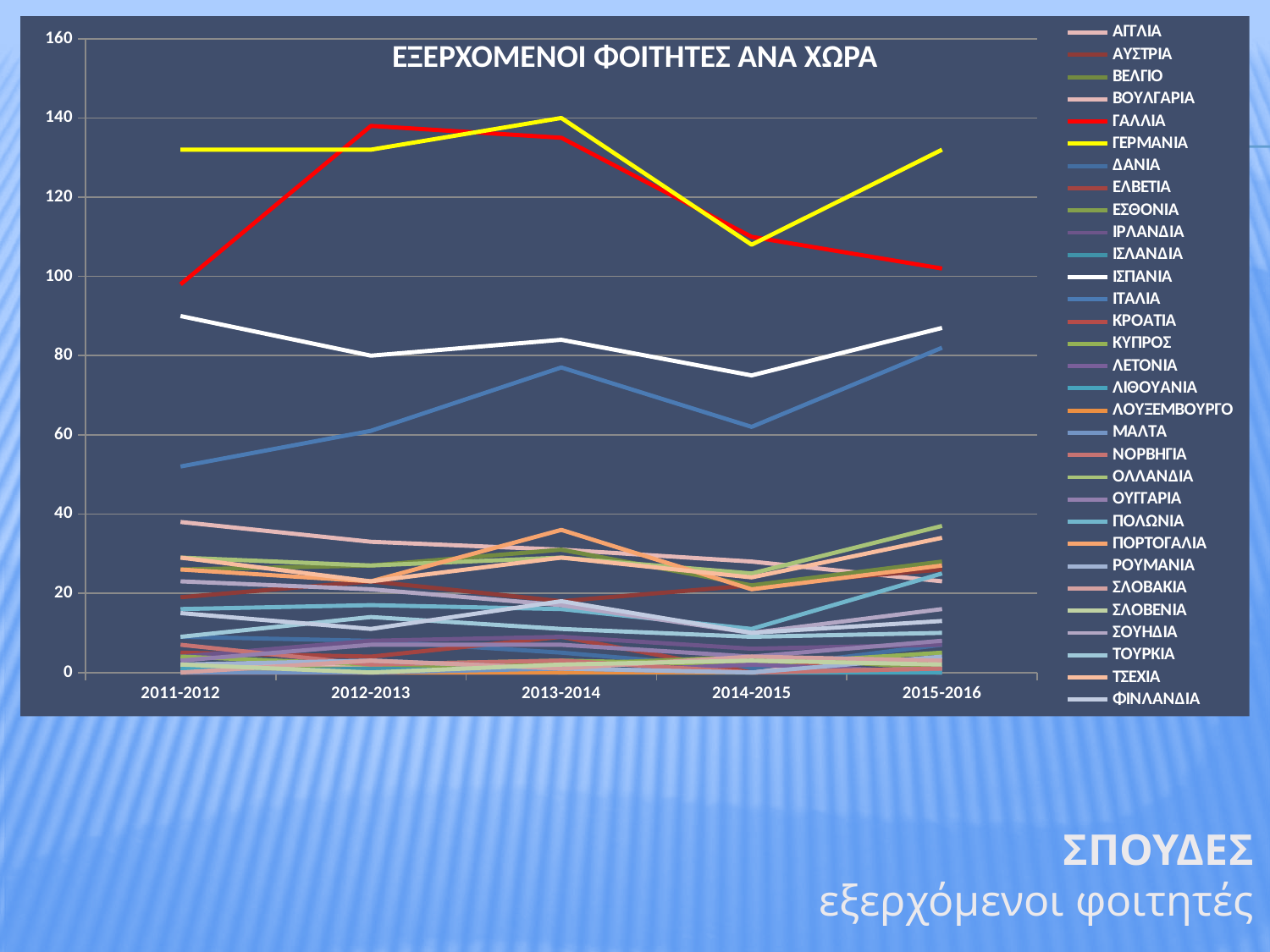
Which is larger in 2011-2012, the value for ΙΣΠΑΝΙΑ or the value for ΙΤΑΛΙΑ? ΙΣΠΑΝΙΑ How many academic years are shown on the x axis? 5 Which is larger in 2015-2016, the value for ΓΑΛΛΙΑ or the value for ΓΕΡΜΑΝΙΑ? ΓΕΡΜΑΝΙΑ What kind of chart is shown on the slide? line chart What is the title of the chart? ΕΞΕΡΧΟΜΕΝΟΙ ΦΟΙΤΗΤΕΣ ΑΝΑ ΧΩΡΑ Is the value for ΙΣΠΑΝΙΑ in 2014-2015 greater or less than 80? less Which country has the highest value in 2015-2016? ΓΕΡΜΑΝΙΑ Which country has the highest value in 2012-2013? ΓΑΛΛΙΑ Does the value for ΓΑΛΛΙΑ rise or fall from 2013-2014 to 2015-2016? fall Is the value for ΓΕΡΜΑΝΙΑ in 2011-2012 greater or less than 120? greater Is the value for ΙΤΑΛΙΑ in 2011-2012 greater or less than 60? less How many series does the legend list? 31